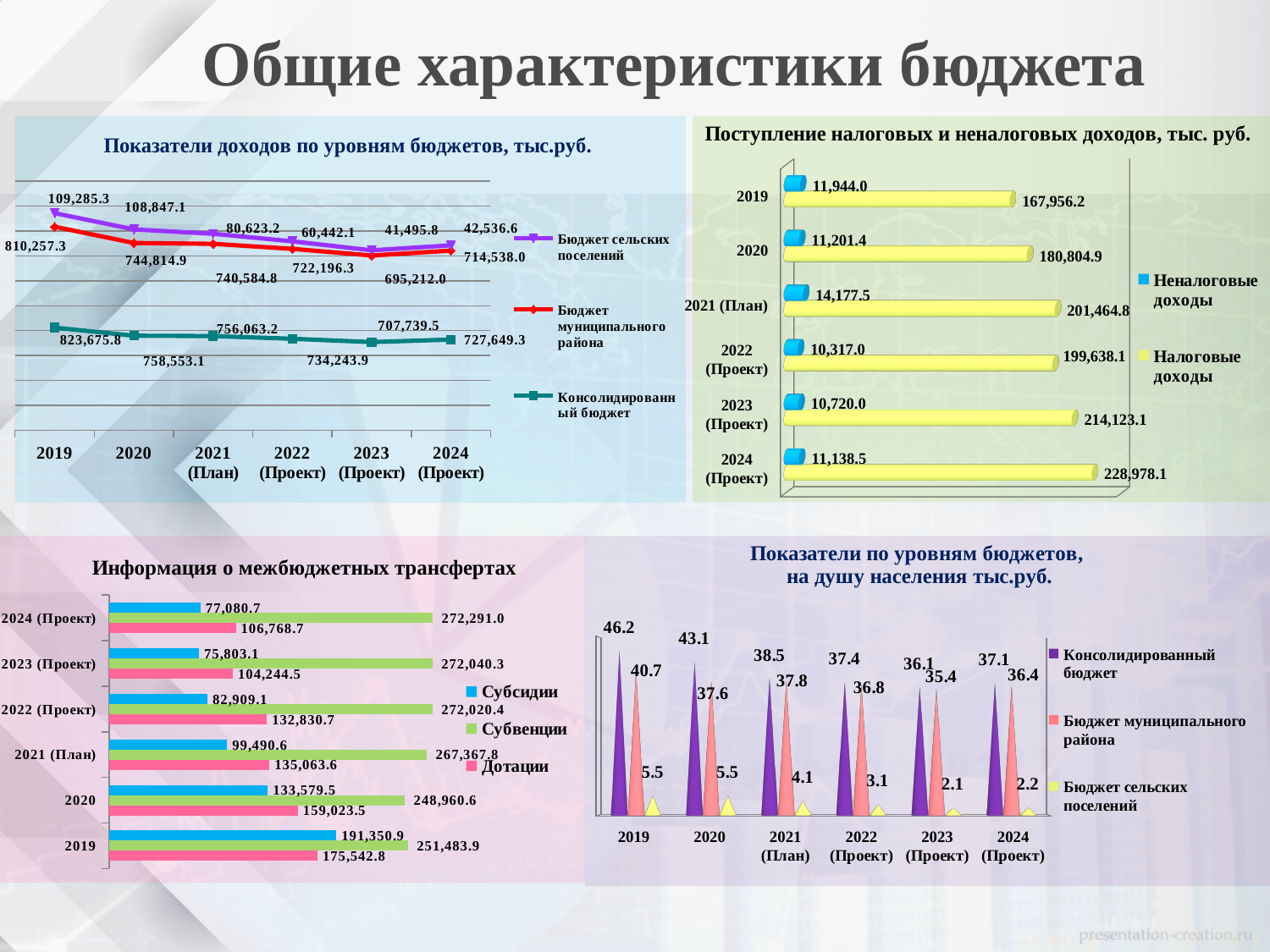
In the chart 'Поступление налоговых и неналоговых доходов, тыс. руб.', what is the value of Налоговые доходы for 2024 (Проект)? 228,978.1 In the chart 'Показатели доходов по уровням бюджетов, тыс.руб.', does the Бюджет сельских поселений series generally rise or fall from 2019 to 2023 (Проект)? fall In the chart 'Поступление налоговых и неналоговых доходов, тыс. руб.', which year has the highest value of Неналоговые доходы? 2021 (План) In the chart 'Информация о межбюджетных трансфертах', what is the value of Субвенции for 2021 (План)? 267,367.8 How many categories are shown on the x axis of the chart 'Показатели по уровням бюджетов, на душу населения тыс.руб.'? 6 In the chart 'Показатели по уровням бюджетов, на душу населения тыс.руб.', which year has the lowest value of Бюджет сельских поселений? 2023 (Проект) In the chart 'Информация о межбюджетных трансфертах', which year has the highest value of Субсидии? 2019 In the chart 'Показатели доходов по уровням бюджетов, тыс.руб.', how many series does the legend list? 3 In the chart 'Показатели по уровням бюджетов, на душу населения тыс.руб.', what is the value of Консолидированный бюджет for 2019? 46.2 In the chart 'Поступление налоговых и неналоговых доходов, тыс. руб.', what is the difference between Налоговые доходы in 2020 and in 2019? 12,848.7 In the chart 'Показатели доходов по уровням бюджетов, тыс.руб.', what is the value of Бюджет сельских поселений for 2023 (Проект)? 41,495.8 In the chart 'Информация о межбюджетных трансфертах', which is larger for 2020: Субсидии or Дотации? Дотации